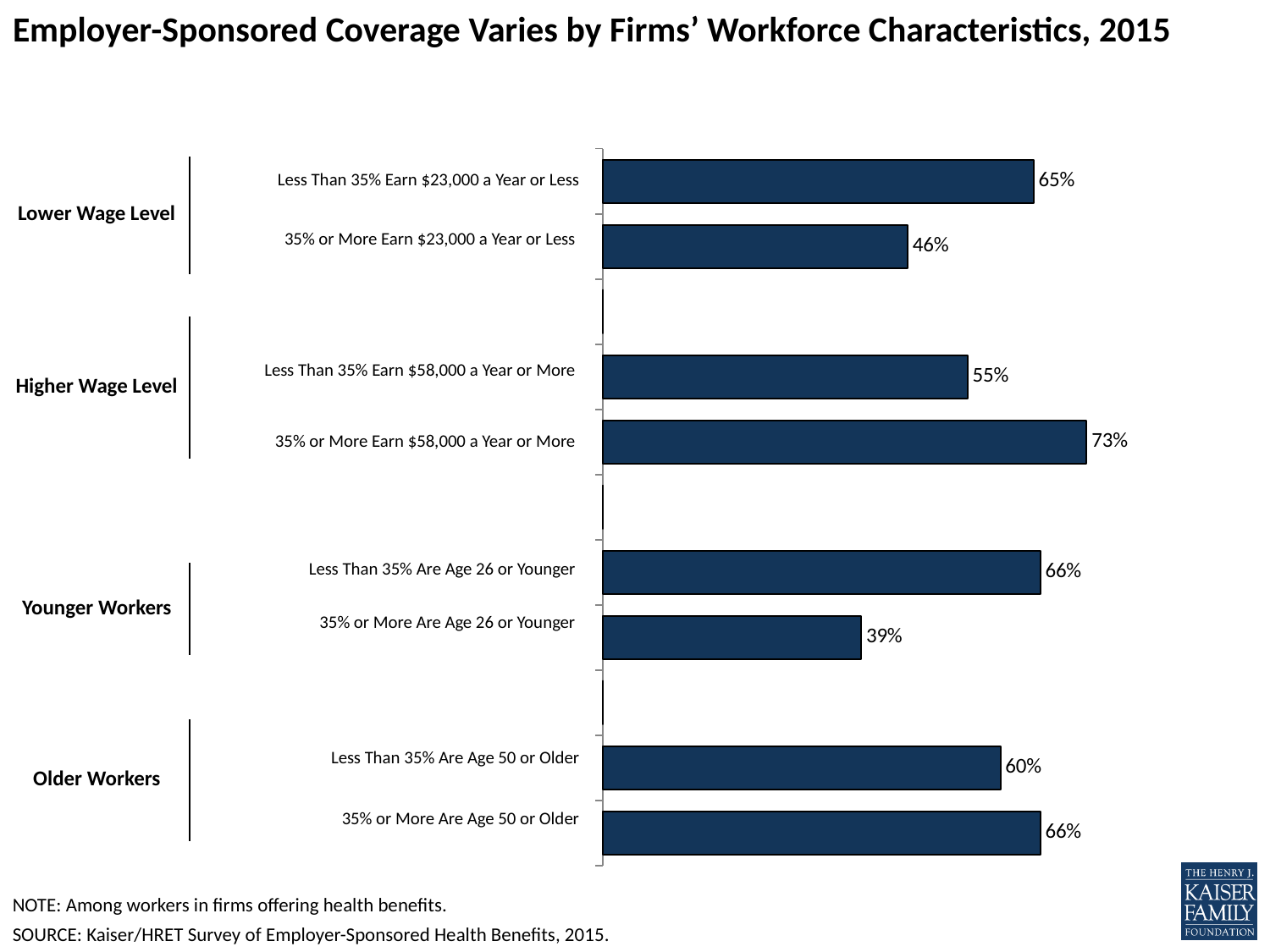
How many workforce characteristic groups are labelled on the left of the chart? 4 How many bars are plotted on the chart? 8 What kind of chart is shown on the slide? Bar chart What is the value for firms where 35% or more earn $23,000 a year or less? 46% What is the value for firms where less than 35% are age 50 or older? 60% What is the value for firms where less than 35% earn $23,000 a year or less? 65% Which is larger: the value for firms where less than 35% earn $58,000 a year or more, or the value for firms where 35% or more earn $58,000 a year or more? 35% or More Earn $58,000 a Year or More Which category has the highest value? 35% or More Earn $58,000 a Year or More Which category has the lowest value? 35% or More Are Age 26 or Younger What is the value for firms where 35% or more earn $58,000 a year or more? 73% What is the difference between the values for firms where less than 35% are age 26 or younger and firms where 35% or more are age 26 or younger? 27 percentage points What is the value for firms where 35% or more are age 26 or younger? 39%